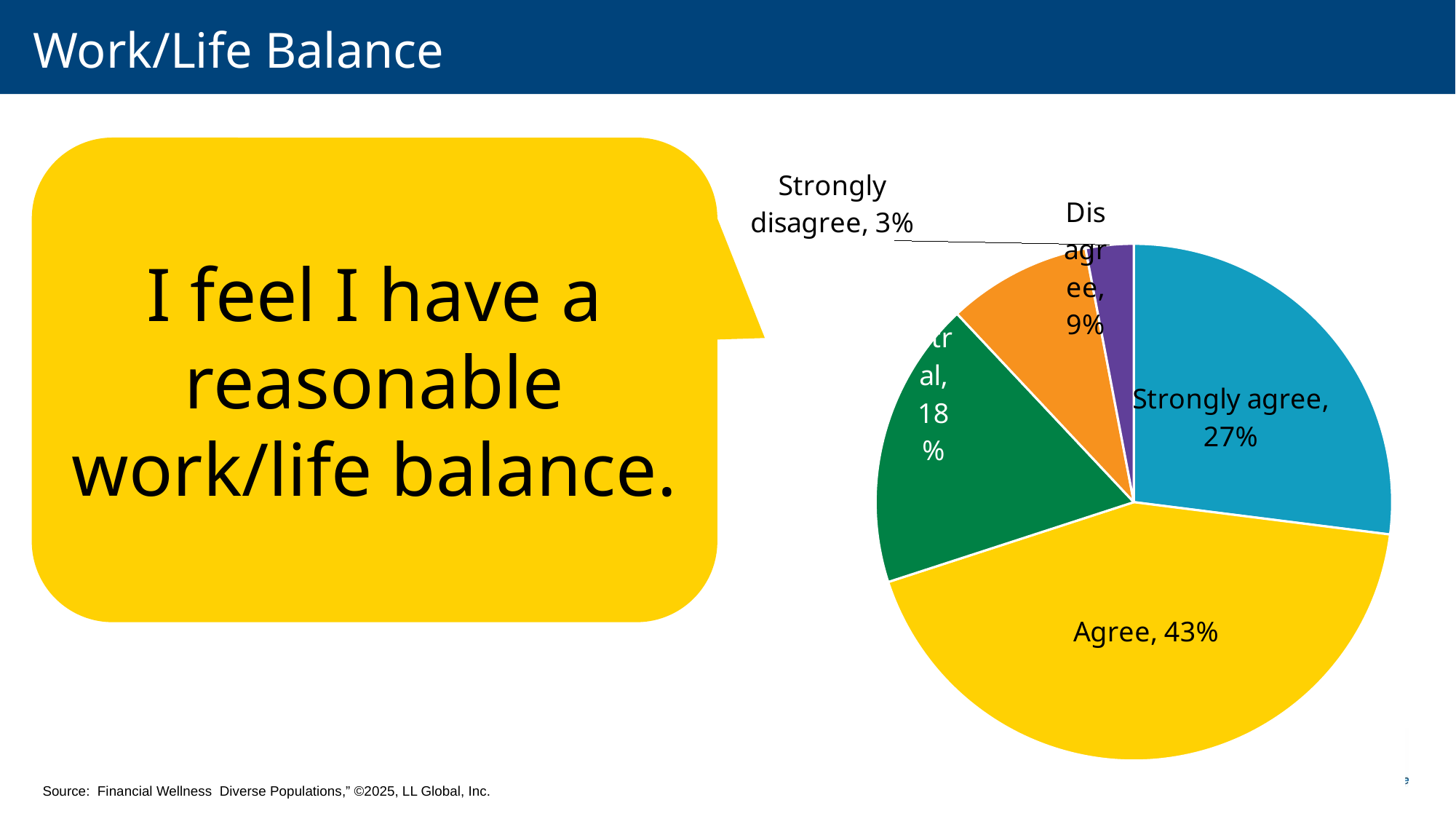
What percentage of respondents answered "Agree"? 43% How many slices does the pie chart have? 5 What value is shown on the green slice of the pie chart? 18% Which response has the largest share of the pie? Agree How many percentage points larger is "Agree" than "Strongly agree"? 16 What percentage of respondents answered "Disagree"? 9% Which response has the smallest share of the pie? Strongly disagree What percentage of respondents answered "Strongly disagree"? 3% What kind of chart is shown on the slide? pie chart What colour is the "Agree" slice of the pie chart? yellow Which is larger, the share for "Disagree" or the share for "Strongly disagree"? Disagree What percentage of respondents answered "Strongly agree"? 27%